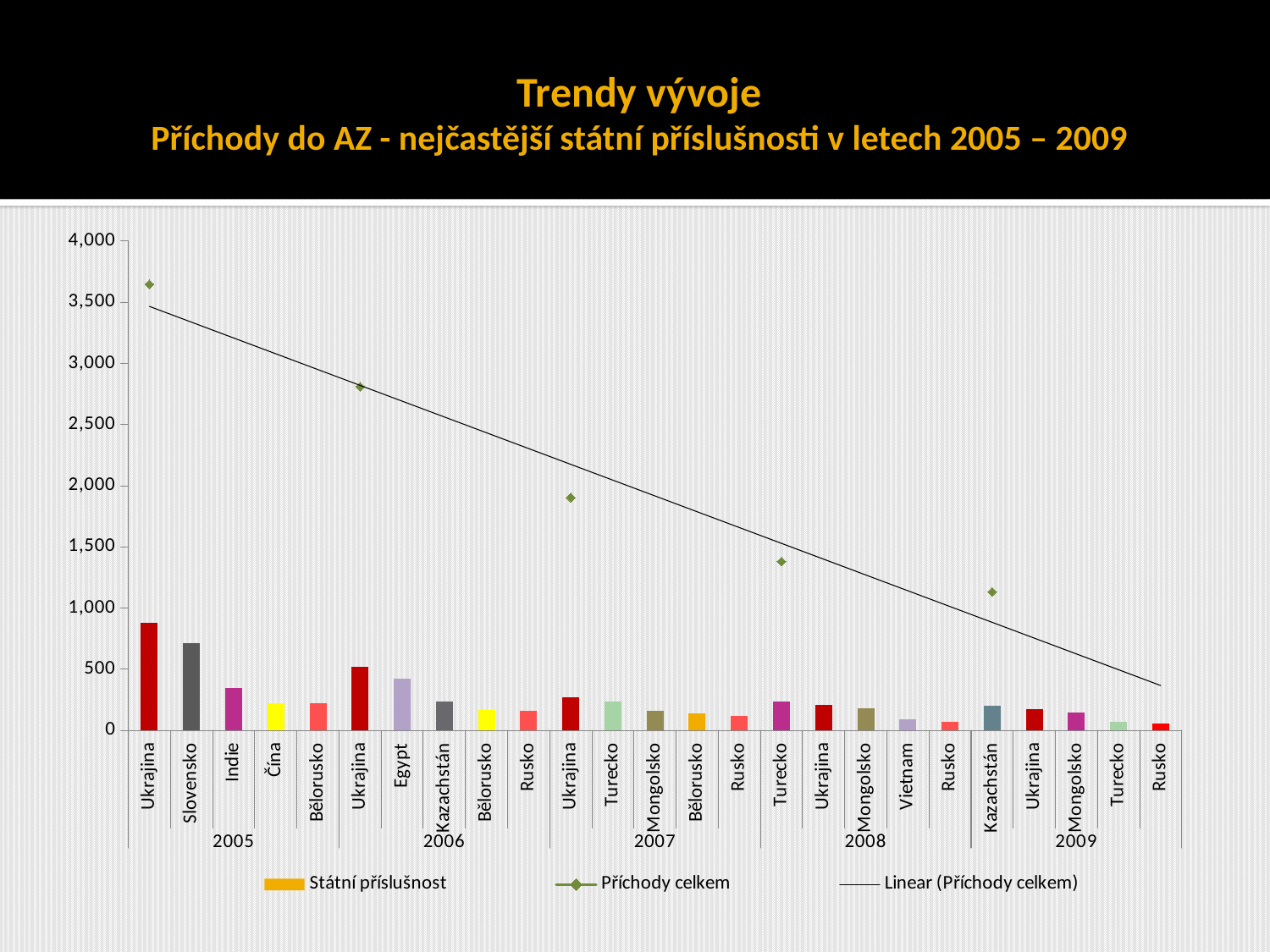
How many series does the legend list? 3 Which nationality bar is the highest in the whole chart? Ukrajina (2005) What is the name of the third legend entry? Linear (Příchody celkem) How many years are shown along the x axis? 5 Is the bar for Ukrajina in 2005 greater or less than 500? greater What kind of chart is shown on the slide? bar chart with a line/marker series Is the 'Příchody celkem' value for 2005 greater or less than 3,500? greater Which is larger, the bar for Slovensko in 2005 or the bar for Egypt in 2006? Slovensko in 2005 Do the values of the 'Příchody celkem' series rise or fall from 2005 to 2009? fall How many bars (nationality categories) are plotted across all years? 25 Is the 'Příchody celkem' value for 2007 greater or less than 2,000? less